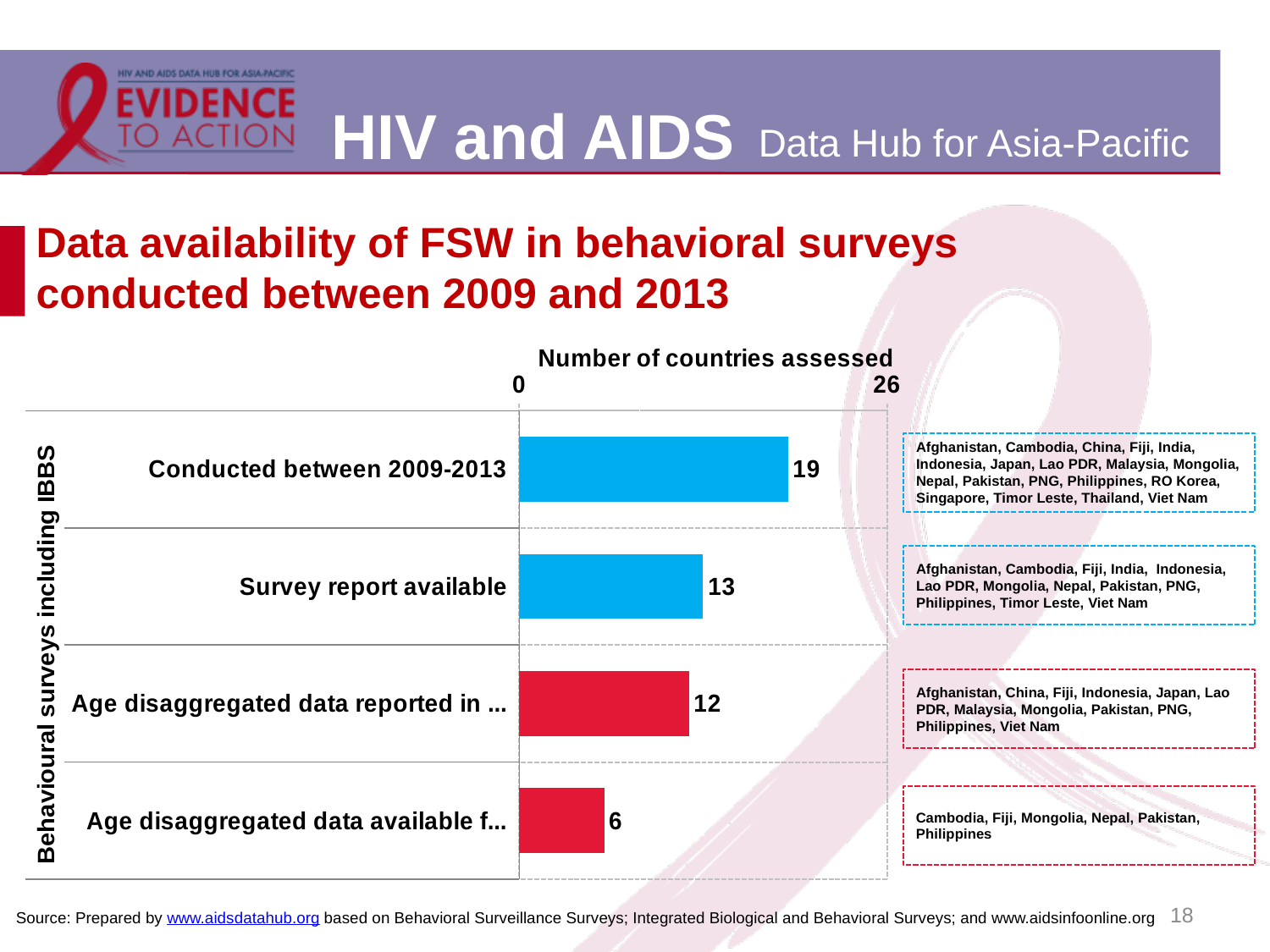
What is the number of countries assessed for 'Conducted between 2009-2013'? 19 What is the difference between the values for 'Age disaggregated data reported in ...' and 'Age disaggregated data available f...'? 6 Which category has the highest number of countries assessed? Conducted between 2009-2013 What kind of chart is shown on the slide? Bar chart What is the maximum value shown on the chart's axis? 26 What is the number of countries assessed for 'Survey report available'? 13 How many categories are shown in the chart? 4 What is the value for 'Age disaggregated data available f...'? 6 What is the value for 'Age disaggregated data reported in ...'? 12 Which category has the lowest number of countries assessed? Age disaggregated data available f... What is the difference between the values for 'Conducted between 2009-2013' and 'Survey report available'? 6 Which is larger: the value for 'Survey report available' or for 'Age disaggregated data reported in ...'? Survey report available